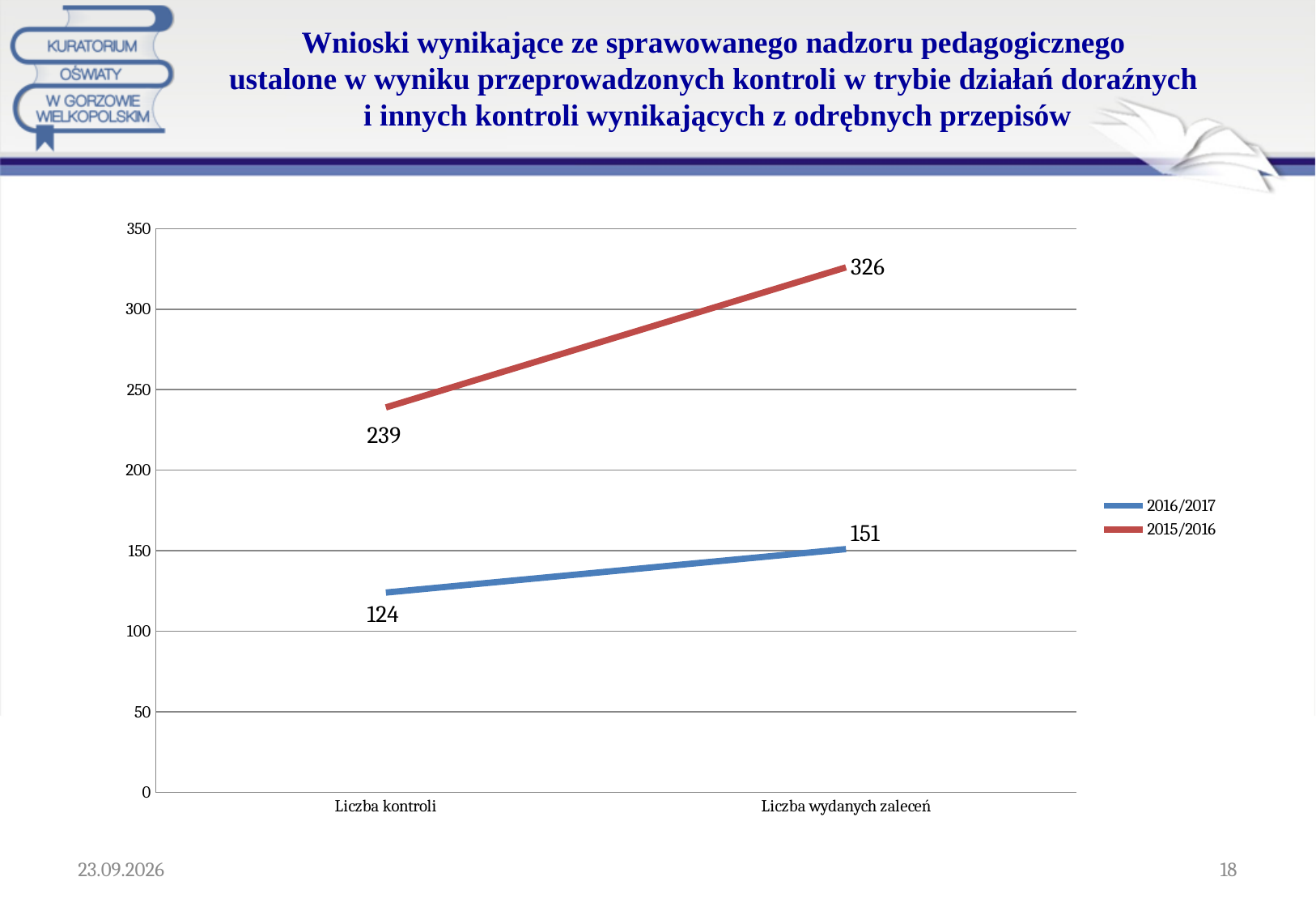
What kind of chart is shown on the slide? line chart Which is larger: the 2016/2017 value for Liczba wydanych zaleceń or the 2015/2016 value for Liczba kontroli? 2015/2016 value for Liczba kontroli What is the difference between the 2015/2016 and 2016/2017 values for Liczba kontroli? 115 What is the value for Liczba wydanych zaleceń in the 2016/2017 series? 151 What is the value for Liczba kontroli in the 2015/2016 series? 239 How many series does the legend list? 2 Do the values of the 2016/2017 series rise or fall from Liczba kontroli to Liczba wydanych zaleceń? rise How many categories are shown on the x axis? 2 What is the value for Liczba wydanych zaleceń in the 2015/2016 series? 326 What is the value for Liczba kontroli in the 2016/2017 series? 124 What is the difference between Liczba wydanych zaleceń and Liczba kontroli in the 2015/2016 series? 87 Which series has the higher value for Liczba wydanych zaleceń? 2015/2016